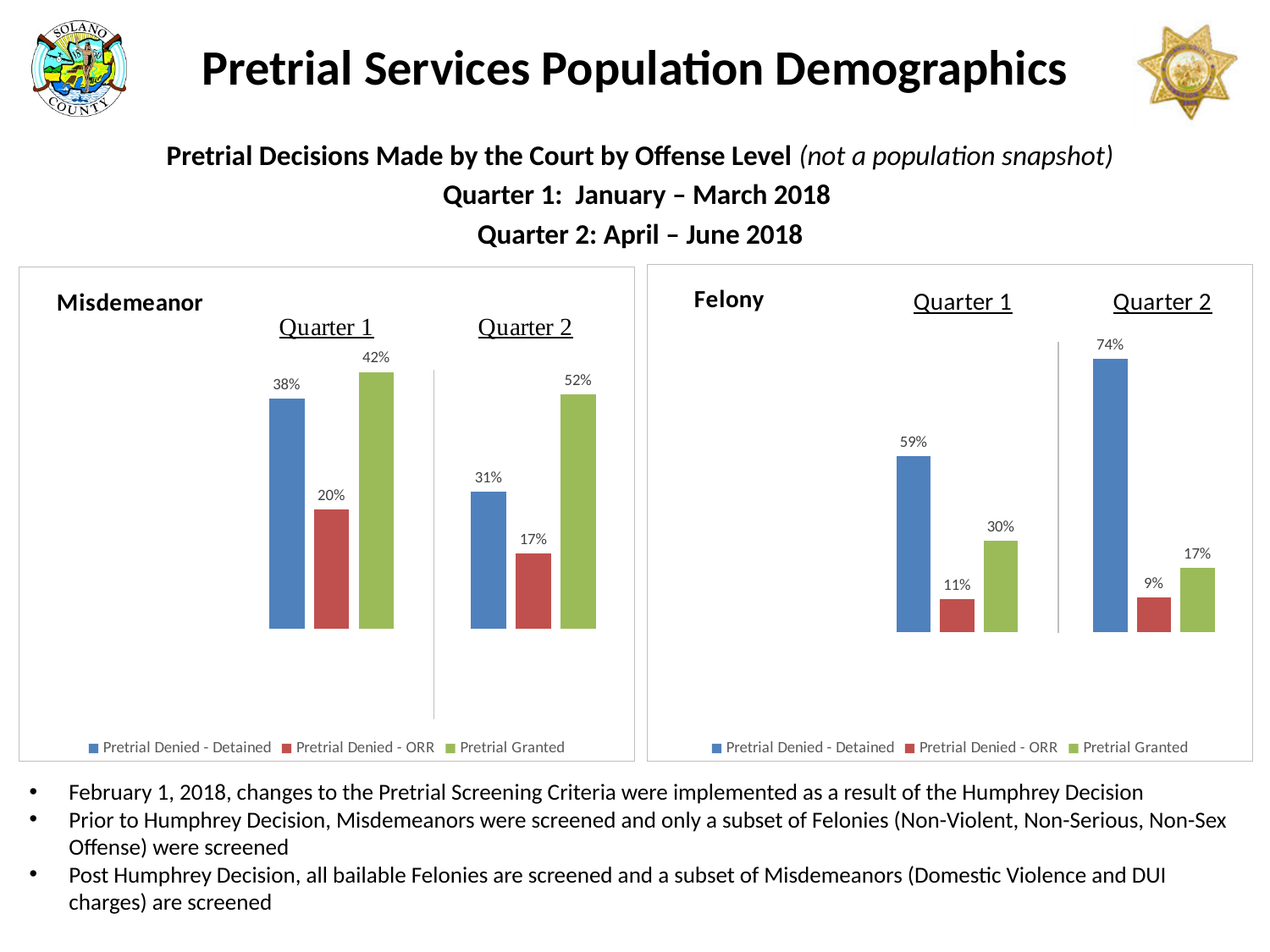
In the Misdemeanor chart, which category has the lowest value in Quarter 2? Pretrial Denied - ORR In the Felony chart, what is the difference between Pretrial Denied - Detained in Quarter 2 and Quarter 1? 15% What type of chart is the Misdemeanor chart? Bar chart In the Felony chart, what is the value for Pretrial Denied - Detained in Quarter 1? 59% In the Misdemeanor chart, how does Pretrial Denied - Detained change from Quarter 1 to Quarter 2? It falls from 38% to 31% How many series does the legend of the Felony chart list? 3 In the Felony chart, is Pretrial Granted larger in Quarter 1 or Quarter 2? Quarter 1 In the Felony chart, which category has the highest value in Quarter 2? Pretrial Denied - Detained In the Misdemeanor chart, what is the value for Pretrial Granted in Quarter 2? 52% In the Misdemeanor chart, what is the value for Pretrial Denied - ORR in Quarter 1? 20% In the Misdemeanor chart, what is the difference between Pretrial Granted and Pretrial Denied - Detained in Quarter 1? 4% In the Felony chart, what is the value for Pretrial Denied - ORR in Quarter 2? 9%